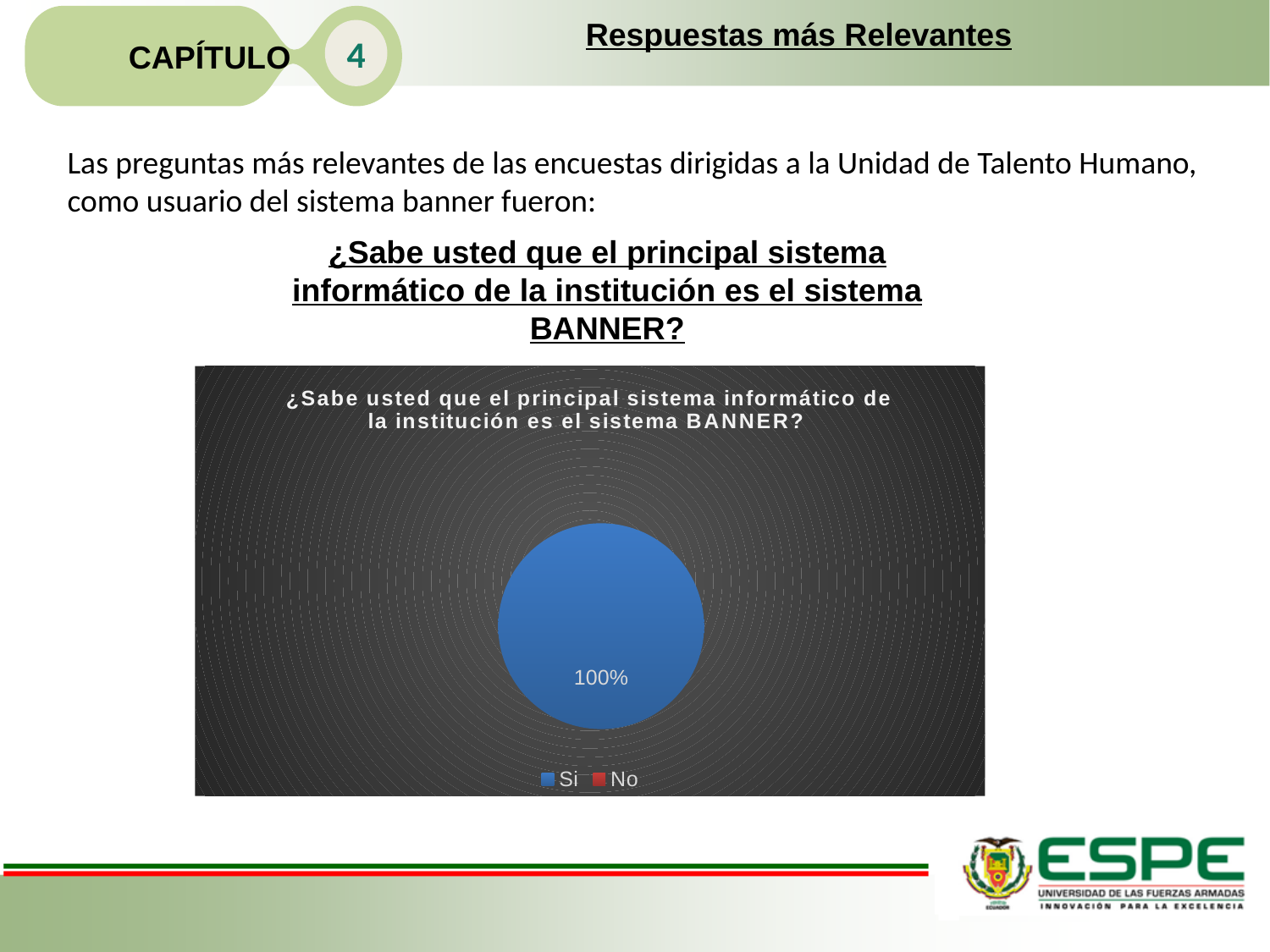
Which is larger, the share for "Si" or the share for "No"? Si What kind of chart is shown on the slide? pie chart How many entries does the chart legend list? 2 What is the only percentage label printed on the pie chart? 100% What colour is the "Si" slice in the pie chart? blue Which category has the largest share of the pie? Si What is the title of the chart? ¿Sabe usted que el principal sistema informático de la institución es el sistema BANNER? Which category has the smallest share of the pie? No What share of the pie does the "Si" slice represent? 100%